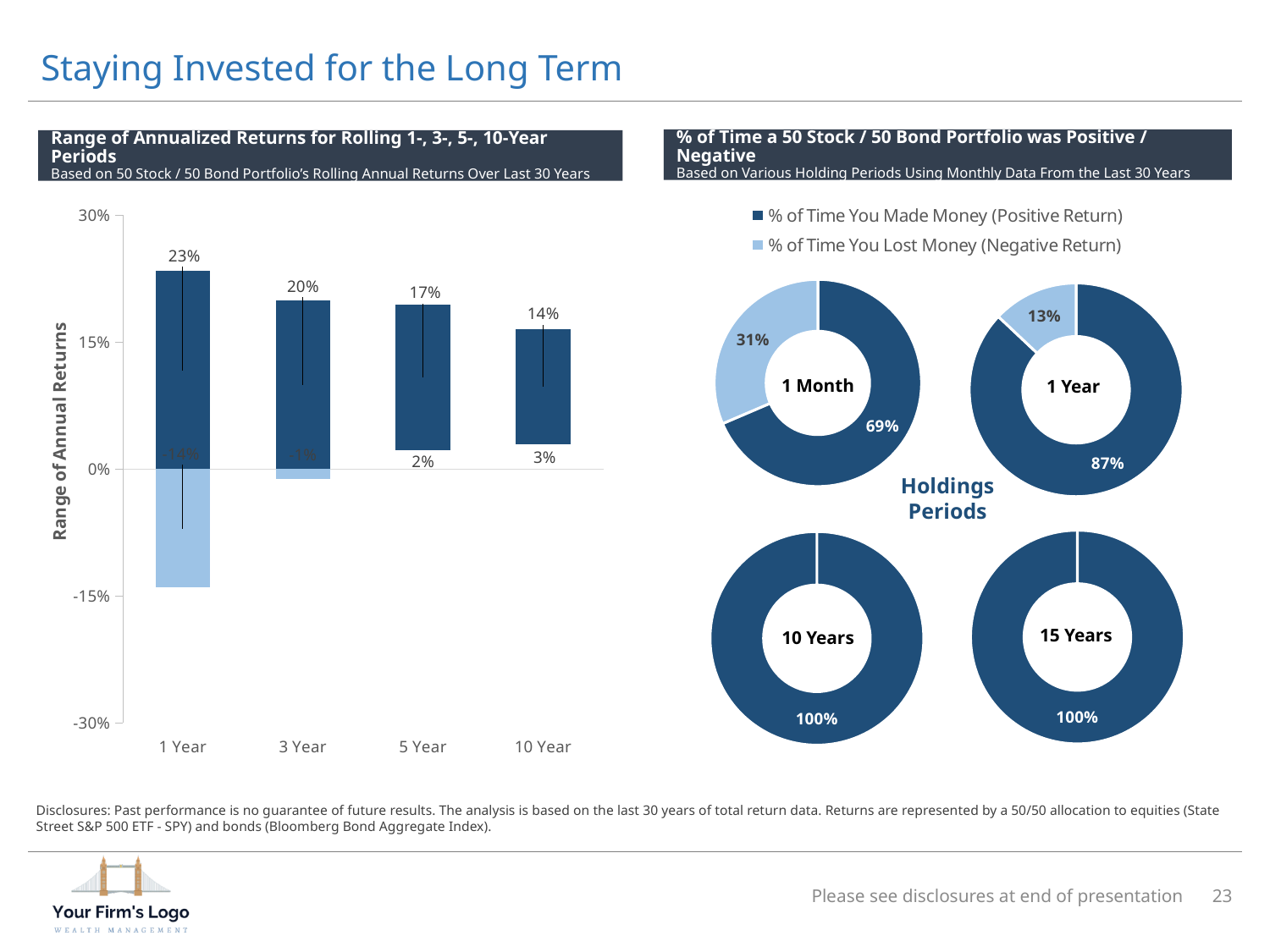
In the '% of Time a 50 Stock / 50 Bond Portfolio was Positive / Negative' chart, what percentage of the time did the portfolio make money over a 1 Month holding period? 69% In the '% of Time a 50 Stock / 50 Bond Portfolio was Positive / Negative' chart, which holding period has a larger share of positive returns: 1 Month or 1 Year? 1 Year In the 'Range of Annualized Returns' bar chart, what is the lowest annualized return shown for the 1 Year period? -14% In the 'Range of Annualized Returns' bar chart, which rolling period has the lowest maximum annualized return? 10 Year In the 'Range of Annualized Returns' bar chart, what is the lowest annualized return shown for the 10 Year period? 3% In the 'Range of Annualized Returns' bar chart, how many rolling periods are shown on the x axis? 4 In the 'Range of Annualized Returns' bar chart, do the maximum annualized returns rise or fall as the rolling period lengthens from 1 Year to 10 Year? Fall In the 'Range of Annualized Returns' bar chart, what is the highest annualized return shown for the 1 Year period? 23% In the 'Range of Annualized Returns' bar chart, what is the difference between the maximum return for the 1 Year period (23%) and the 10 Year period (14%)? 9% In the 'Range of Annualized Returns' bar chart, which rolling period has the highest maximum annualized return? 1 Year How many series does the legend of the '% of Time a 50 Stock / 50 Bond Portfolio was Positive / Negative' chart list? 2 In the '% of Time a 50 Stock / 50 Bond Portfolio was Positive / Negative' chart, what percentage of the time did the portfolio lose money over a 1 Year holding period? 13%